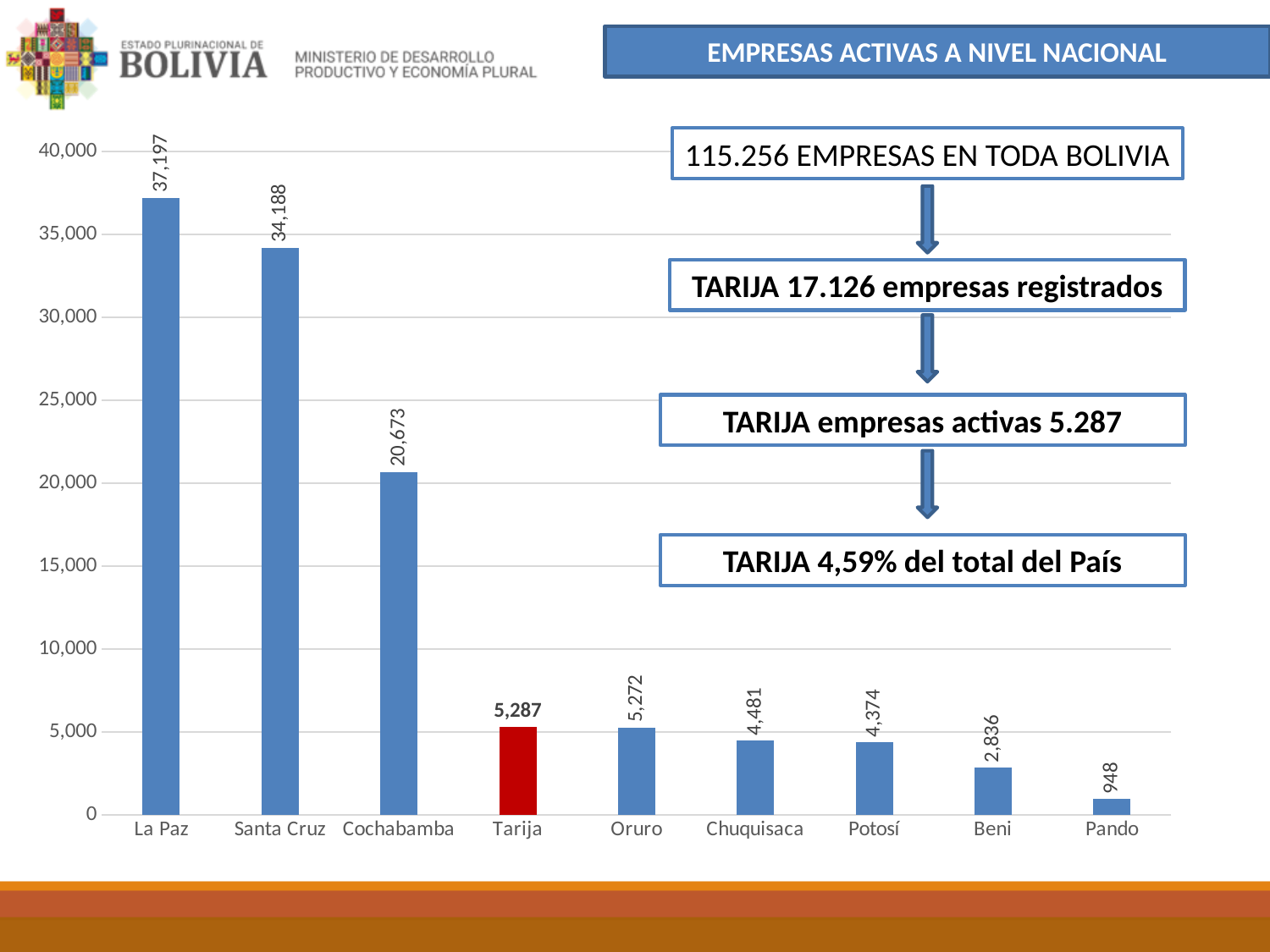
Is the value for Cochabamba greater or less than 20,000? greater What is the value for La Paz? 37,197 How many categories are shown on the x axis? 9 What is the difference between the values for La Paz and Santa Cruz? 3,009 What kind of chart is shown on the slide? bar chart What is the value for Tarija? 5,287 Which category has the lowest value? Pando Which is larger, the value for Cochabamba or the value for Santa Cruz? Santa Cruz What is the value for Pando? 948 Which category has the highest value? La Paz Do the values rise or fall from La Paz to Pando along the x axis? fall Which bar is coloured red? Tarija